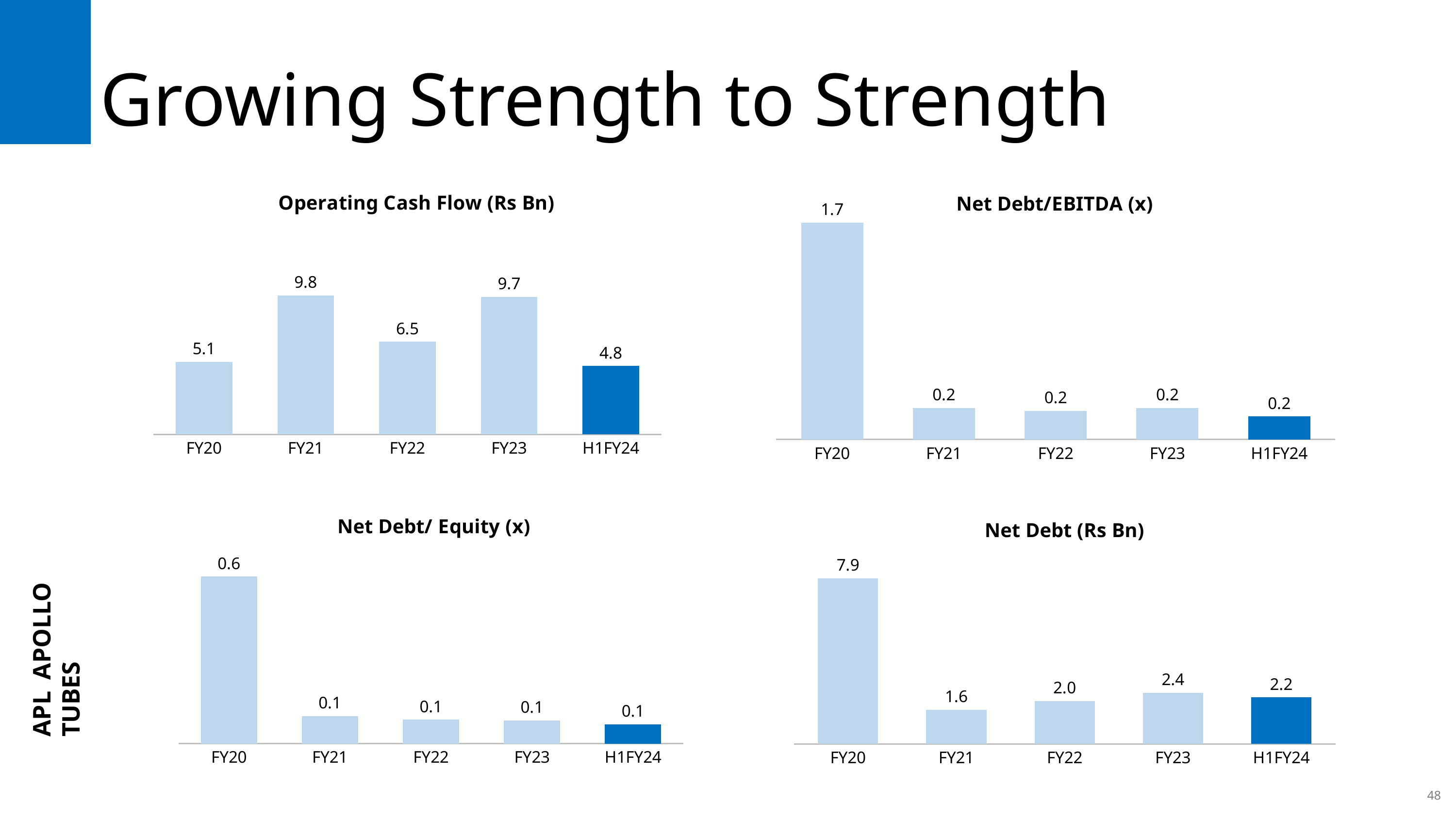
In the Net Debt/EBITDA (x) chart, how many categories are shown on the x axis? 5 In the Operating Cash Flow (Rs Bn) chart, what is the difference between FY23 and FY22? 3.2 In the Net Debt/ Equity (x) chart, what is the value for H1FY24? 0.1 In the Net Debt/ Equity (x) chart, what is the value for FY20? 0.6 What kind of chart is the Net Debt (Rs Bn) chart? Bar chart In the Net Debt (Rs Bn) chart, which is larger, FY23 or H1FY24? FY23 In the Net Debt (Rs Bn) chart, what is the difference between FY20 and FY21? 6.3 In the Net Debt/EBITDA (x) chart, what is the value for FY20? 1.7 In the Operating Cash Flow (Rs Bn) chart, what is the value for FY21? 9.8 In the Operating Cash Flow (Rs Bn) chart, which year has the highest value? FY21 How many charts are shown on the slide? 4 In the Net Debt (Rs Bn) chart, which year has the lowest value? FY21